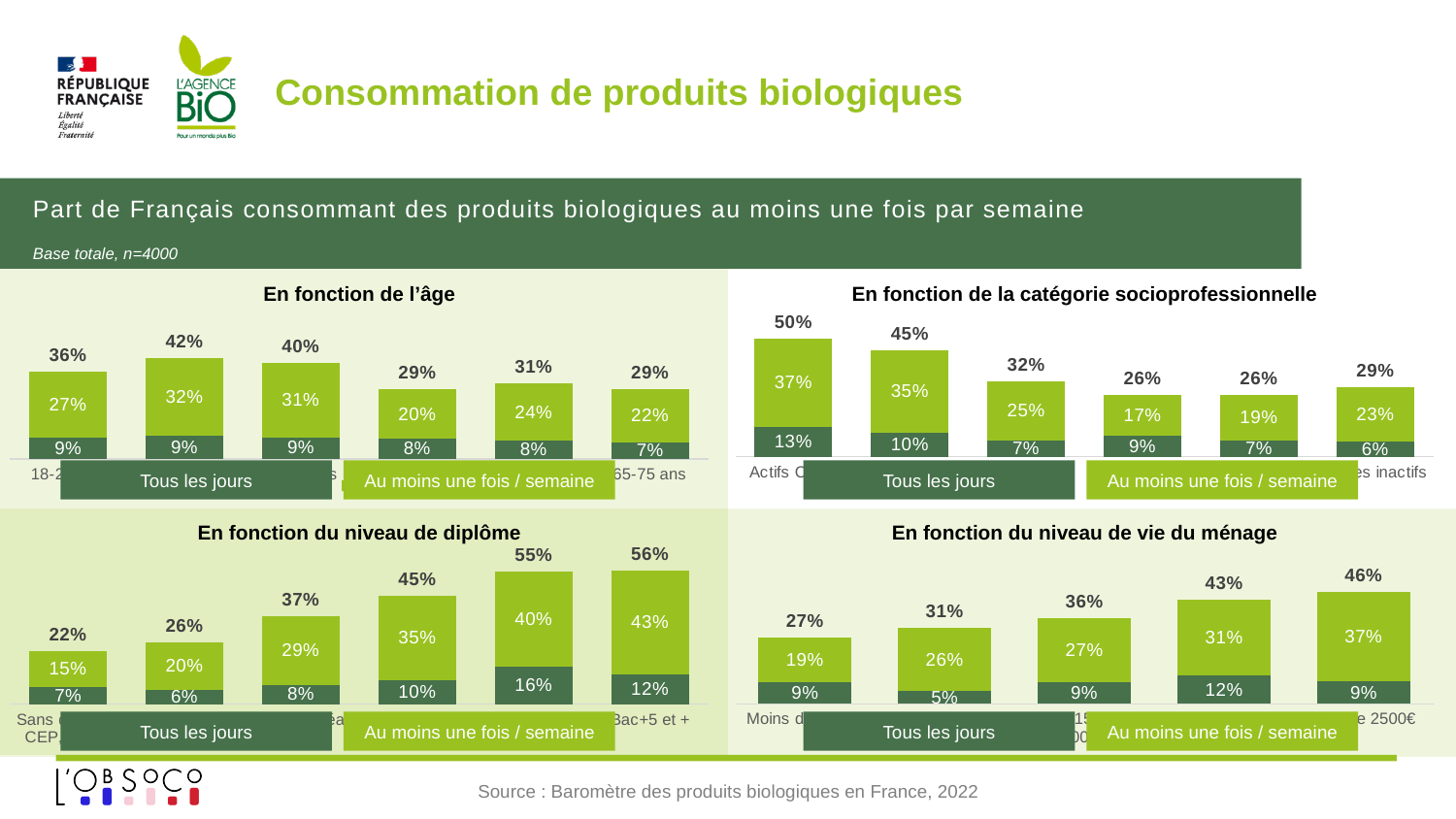
How many bars are there in the chart 'En fonction du niveau de vie du ménage'? 5 In the chart 'En fonction de la catégorie socioprofessionnelle', what is the highest total value shown above a bar? 50% In the chart 'En fonction de l'âge', what is the highest total value shown above a bar? 42% In the chart 'En fonction de l'âge', what is the 'Tous les jours' value for 65-75 ans? 7% In the chart 'En fonction du niveau de diplôme', do the total values rise or fall from left to right? rise In the chart 'En fonction du niveau de diplôme', what is the 'Au moins une fois / semaine' value for Bac+5 et +? 43% In the chart 'En fonction du niveau de vie du ménage', which bar has the larger 'Au moins une fois / semaine' value, the first (leftmost) bar or the last (rightmost) bar? the last (rightmost) bar In the chart 'En fonction de l'âge', what is the total share shown above the bar for 65-75 ans? 29% How many series does the legend list in the chart 'En fonction de l'âge'? 2 In the chart 'En fonction du niveau de diplôme', what is the total share shown above the bar for Bac+5 et +? 56% In the chart 'En fonction de l'âge', what is the difference between the 'Au moins une fois / semaine' value and the 'Tous les jours' value for 65-75 ans? 15 percentage points In the chart 'En fonction de la catégorie socioprofessionnelle', what is the 'Tous les jours' value for the first (leftmost) bar? 13%